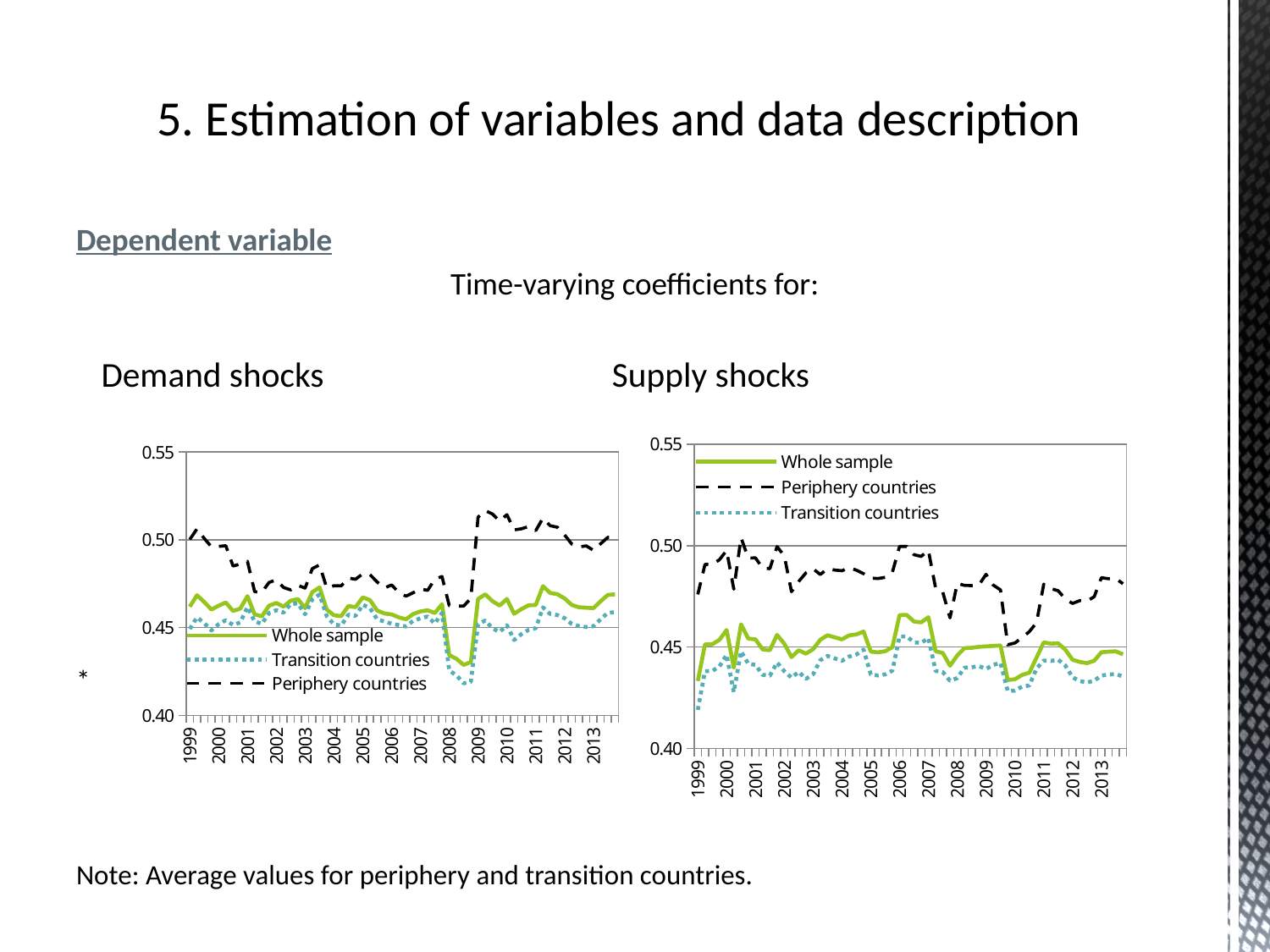
In the Demand shocks chart, which series has the highest values across the period? Periphery countries In the Supply shocks chart, is the value for Periphery countries in 2010 greater or less than 0.50? less In the Demand shocks chart, is the value for Periphery countries in 2010 greater or less than 0.50? greater In the Supply shocks chart, is the value for Whole sample in 2006 greater or less than 0.45? greater What kind of chart is the Demand shocks chart? line chart In the Supply shocks chart, which series has the lowest values across the period? Transition countries How many year labels appear on the x axis of the Demand shocks chart? 15 Which series is drawn with a dashed black line in the Supply shocks chart? Periphery countries How many series does the legend of the Supply shocks chart list? 3 In the Demand shocks chart, which is larger in 2010: Periphery countries or Transition countries? Periphery countries